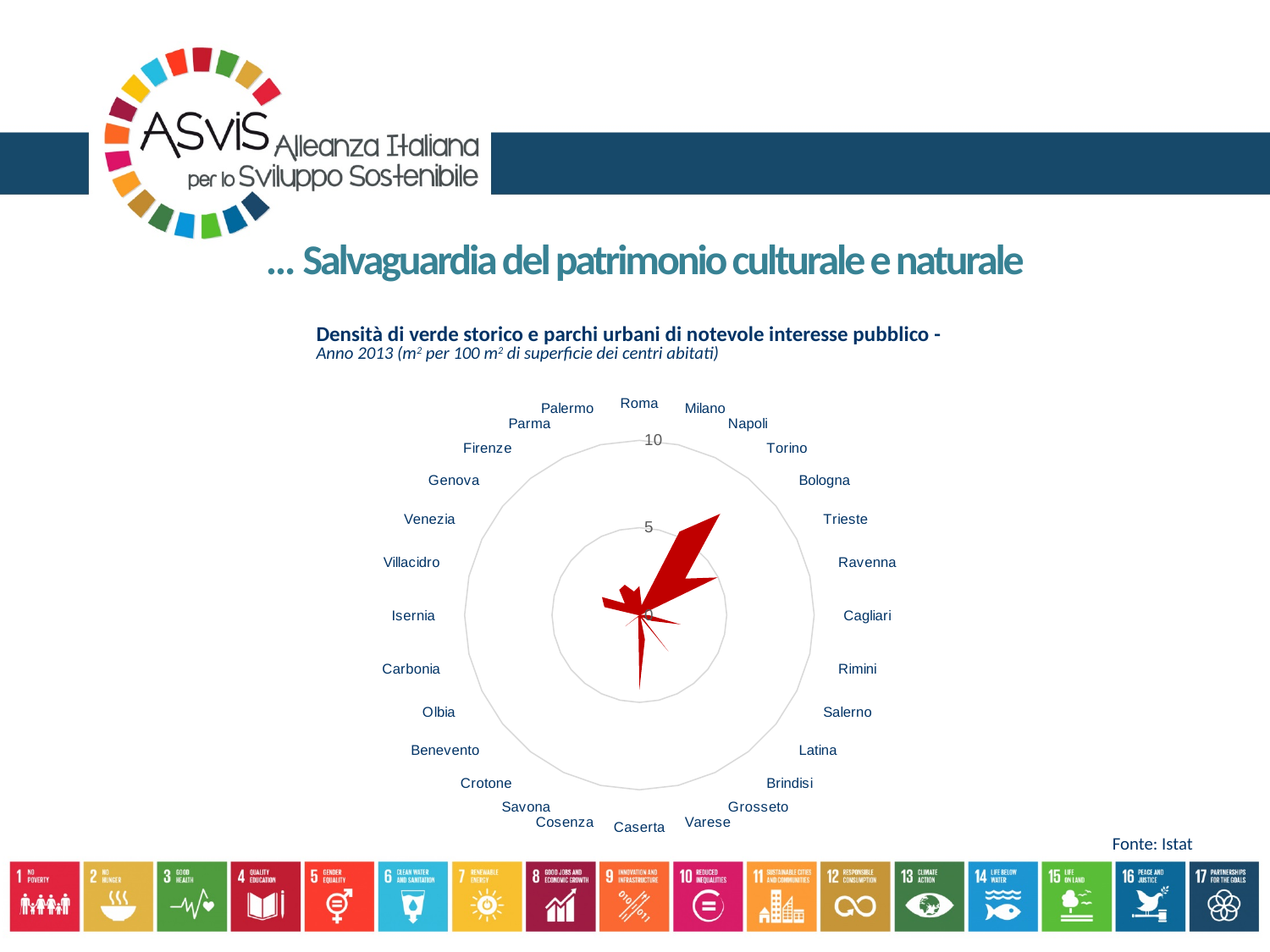
Is the value for Villacidro greater or less than 5? less Is the value for Isernia greater or less than 5? less Which has the larger value, Torino or Carbonia? Torino Is the value for Olbia greater or less than 5? less What is the data source cited for the chart? Istat What kind of chart is shown on the slide? radar chart Which city has the highest value on the radar chart? Torino Which has the larger value, Torino or Isernia? Torino What is the title of the chart? Densità di verde storico e parchi urbani di notevole interesse pubblico How many cities are plotted around the radar chart? 28